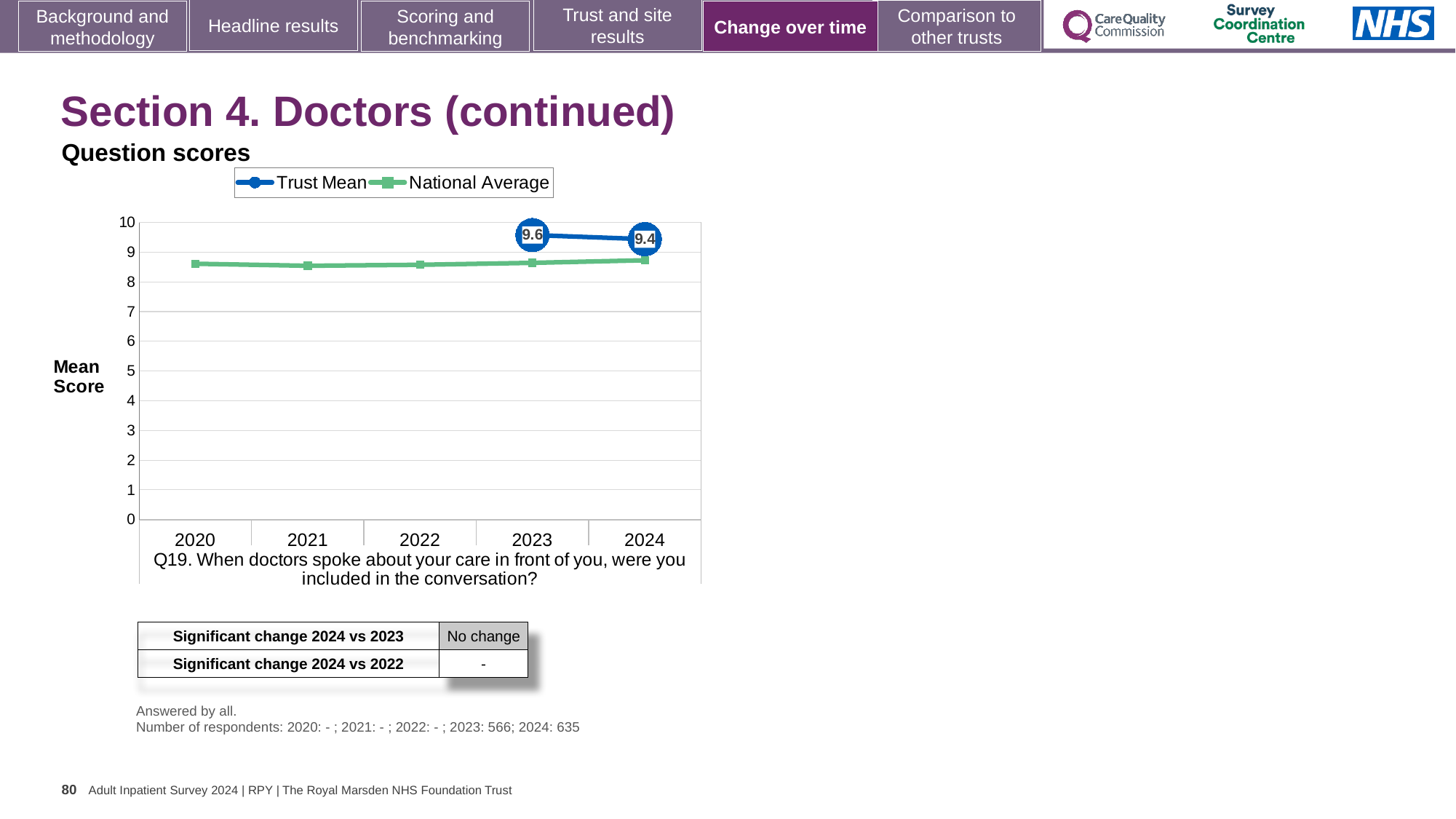
How many years are shown on the x axis? 5 How many series does the legend list? 2 What is the Trust Mean score for 2023? 9.6 In 2024, which series is higher, Trust Mean or National Average? Trust Mean Is the National Average for 2020 greater or less than 8? greater What is the Trust Mean score for 2024? 9.4 What is the label of the y axis? Mean Score What is the difference between the Trust Mean in 2023 and in 2024? 0.2 Is the National Average for 2024 greater or less than 9? less Does the Trust Mean rise or fall from 2023 to 2024? fall What kind of chart is shown? line chart Which year has the higher Trust Mean, 2023 or 2024? 2023